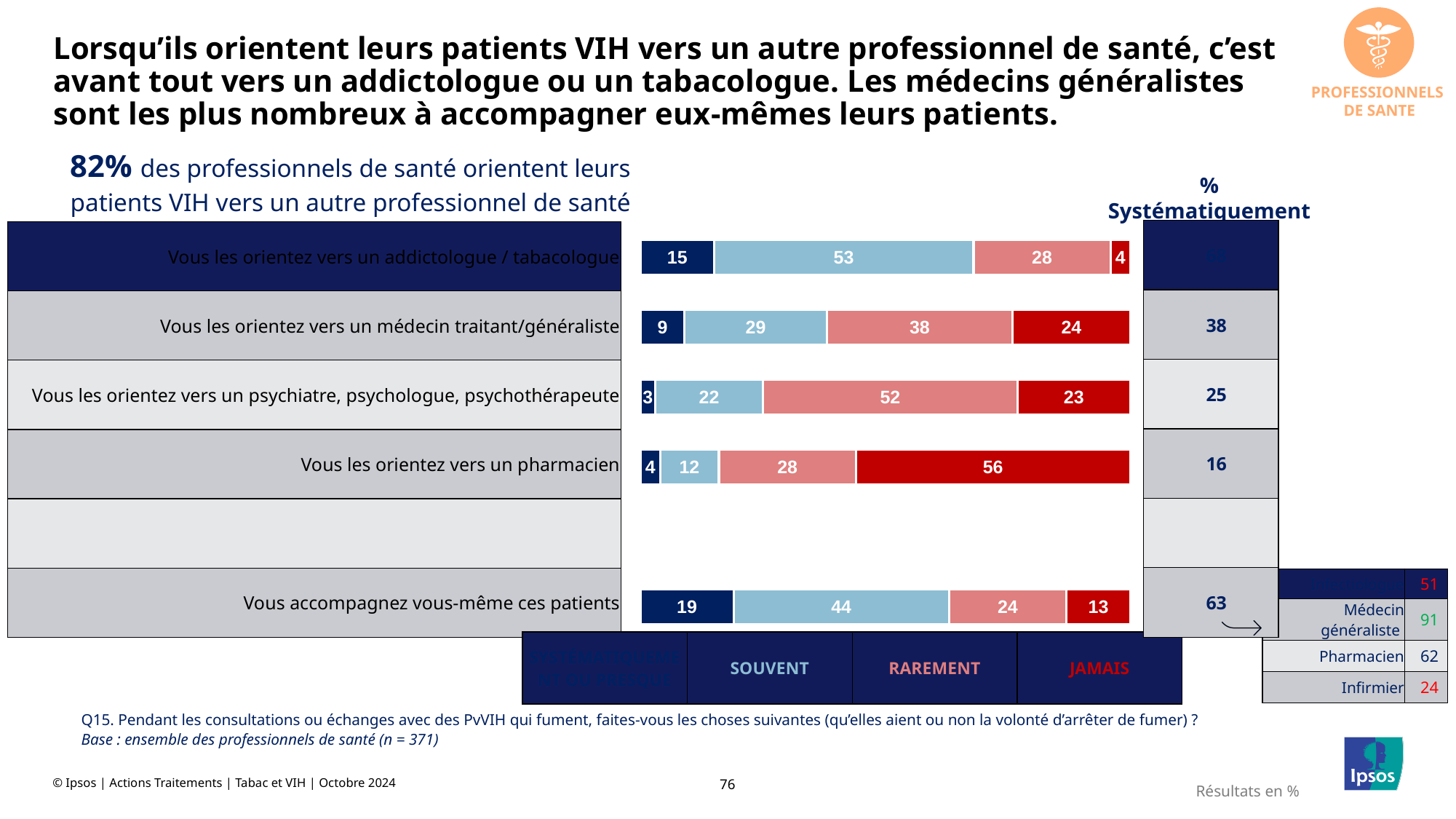
Which category has the lowest 'Jamais' value? Vous les orientez vers un addictologue / tabacologue What is the '% Systématiquement' value shown for 'Vous accompagnez vous-même ces patients'? 63 Which category has the highest 'Jamais' value? Vous les orientez vers un pharmacien What is the 'Rarement' value for 'Vous les orientez vers un psychiatre, psychologue, psychothérapeute'? 52 Which colour represents the 'Jamais' series in the chart? red What type of chart is shown on the slide? stacked bar chart What is the difference between the 'Souvent' values for 'Vous les orientez vers un addictologue / tabacologue' and 'Vous les orientez vers un médecin traitant/généraliste'? 24 How many categories with bars are plotted in the chart? 5 Which is larger: the 'Rarement' value for 'Vous les orientez vers un médecin traitant/généraliste' or for 'Vous les orientez vers un pharmacien'? Vous les orientez vers un médecin traitant/généraliste What is the first (dark blue) segment value for 'Vous accompagnez vous-même ces patients'? 19 What is the 'Souvent' value for 'Vous les orientez vers un addictologue / tabacologue'? 53 What is the 'Jamais' value for 'Vous les orientez vers un pharmacien'? 56